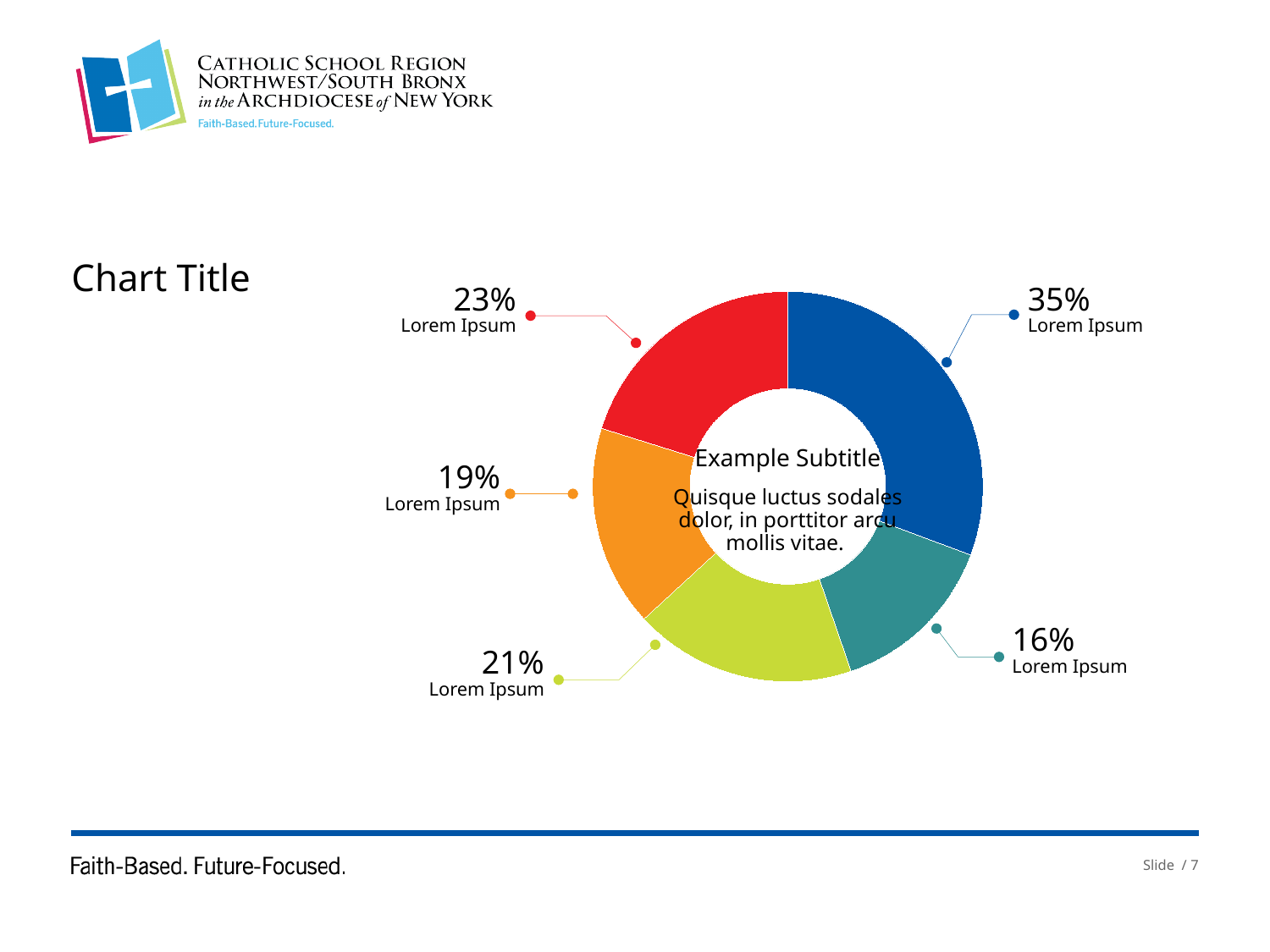
What percentage is labelled on the red slice of the pie chart? 23% What kind of chart is shown on the slide? Pie chart (donut) What is the smallest percentage shown on the pie chart? 16% How many slices does the pie chart have? 5 What percentage is labelled on the orange slice of the pie chart? 19% What percentage is labelled on the lime green slice of the pie chart? 21% What percentage is labelled on the teal slice of the pie chart? 16% What is the title of the chart on the slide? Chart Title Which slice is larger, the red slice or the orange slice? The red slice (23%) What is the difference in percentage points between the largest slice (35%) and the smallest slice (16%)? 19 percentage points What is the largest percentage shown on the pie chart? 35% What percentage is labelled on the dark blue slice of the pie chart? 35%